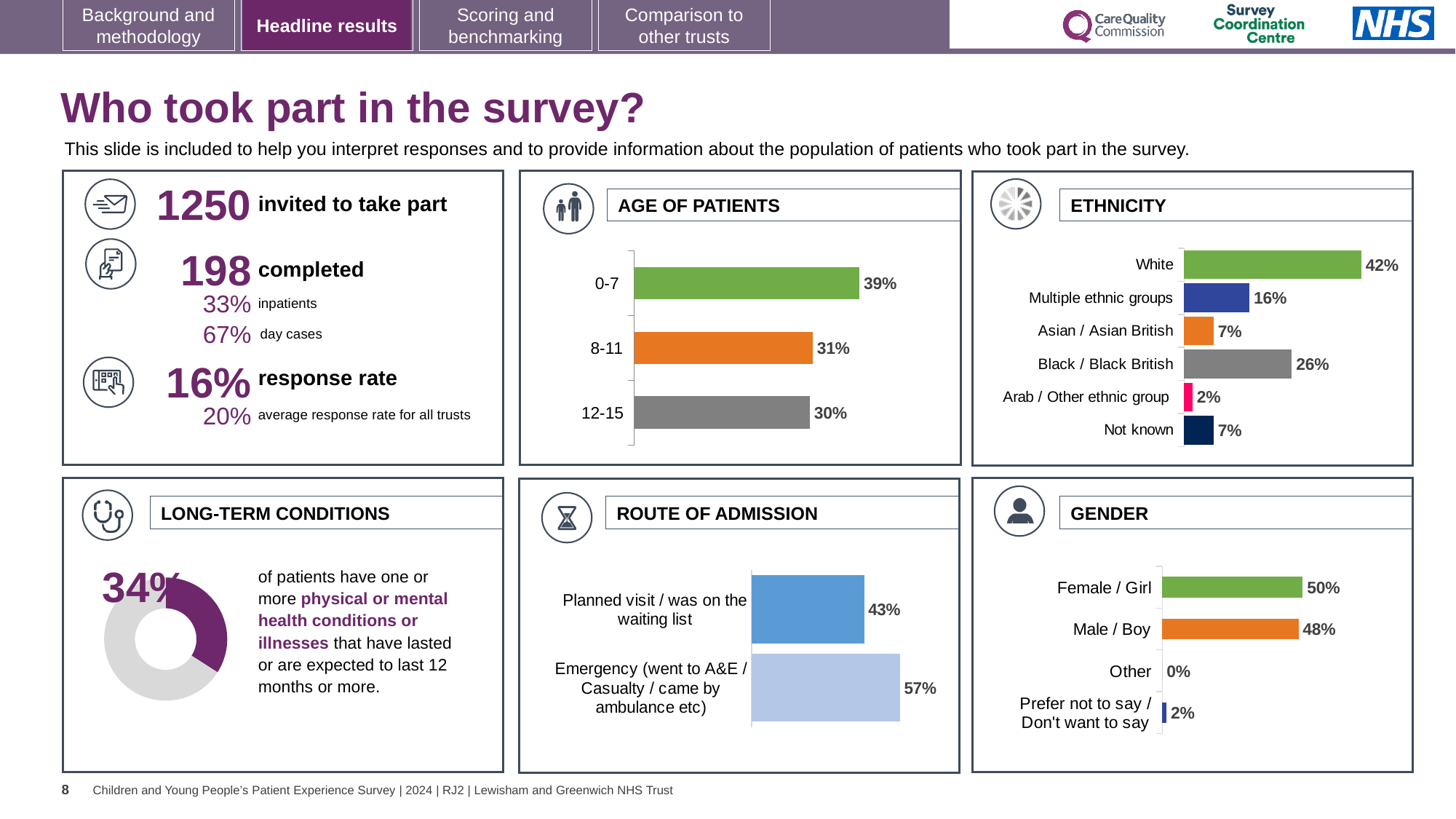
In the AGE OF PATIENTS chart, which age group has the lowest percentage? 12-15 What kind of chart is used in the LONG-TERM CONDITIONS panel? Donut (pie) chart In the GENDER chart, what is the difference between Female / Girl and Male / Boy? 2% In the LONG-TERM CONDITIONS chart, what share of patients have one or more long-term conditions? 34% In the GENDER chart, what is the value for Male / Boy? 48% In the AGE OF PATIENTS chart, what percentage of patients were aged 0-7? 39% In the ETHNICITY chart, how many ethnicity categories are shown? 6 In the ETHNICITY chart, what is the value for Black / Black British? 26% In the ROUTE OF ADMISSION chart, what percentage of patients came via Emergency (went to A&E / Casualty / came by ambulance etc)? 57% In the ETHNICITY chart, which category has the highest percentage? White In the ETHNICITY chart, what is the difference between White and Multiple ethnic groups? 26% In the ROUTE OF ADMISSION chart, which route has the larger value: Planned visit / was on the waiting list or Emergency? Emergency (went to A&E / Casualty / came by ambulance etc)